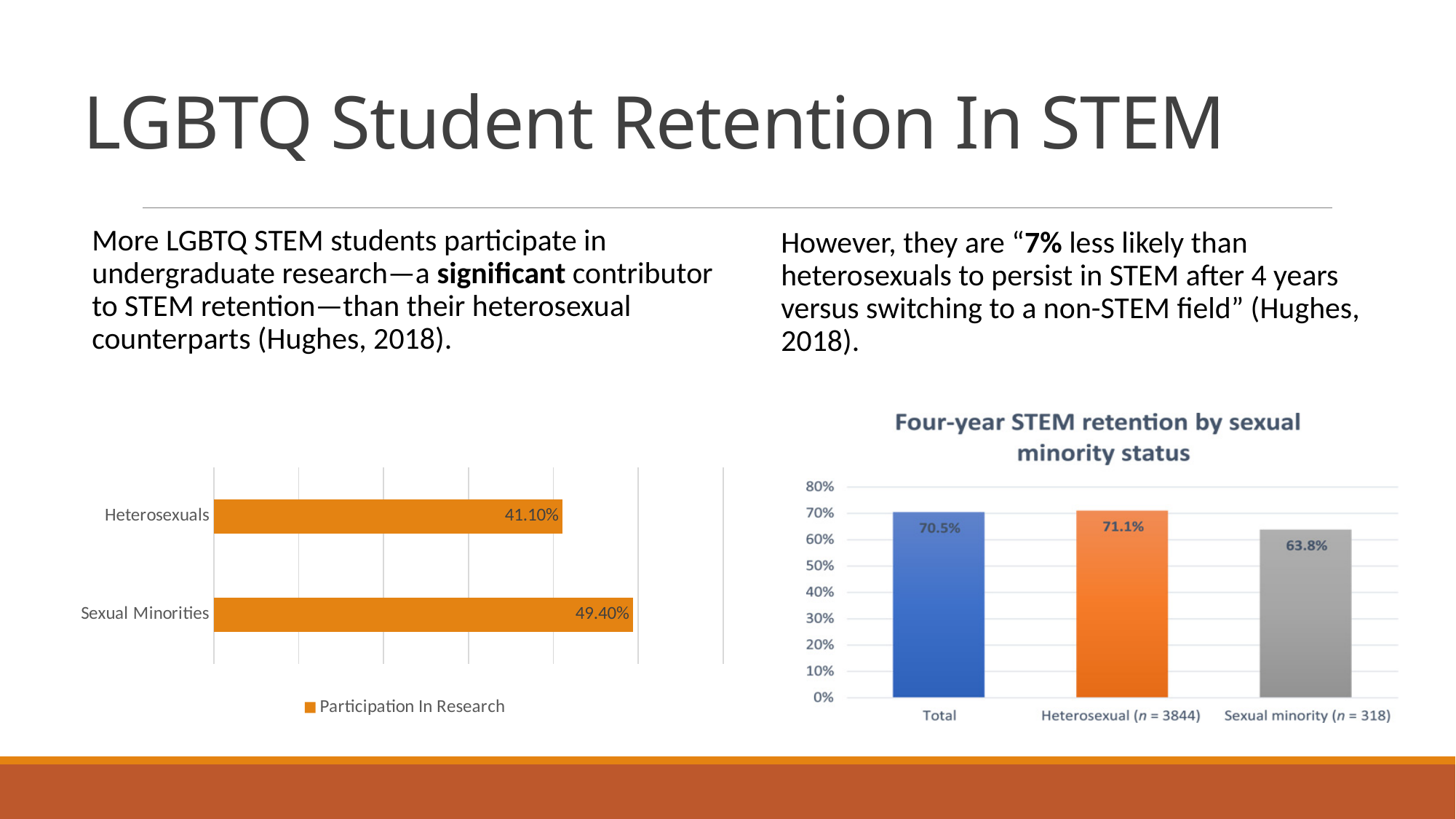
In the left chart, what series name does the legend show? Participation In Research In the left chart (Participation In Research), what is the value for Sexual Minorities? 49.40% What kind of chart is the left chart (Participation In Research)? Bar chart In the chart titled 'Four-year STEM retention by sexual minority status', is the value for Sexual minority (n = 318) greater or less than 70%? less In the chart titled 'Four-year STEM retention by sexual minority status', how many categories are shown? 3 In the chart titled 'Four-year STEM retention by sexual minority status', what is the value for Sexual minority (n = 318)? 63.8% In the chart titled 'Four-year STEM retention by sexual minority status', what is the difference between the Heterosexual (n = 3844) and Sexual minority (n = 318) values? 7.3% In the left chart (Participation In Research), what is the difference between the Sexual Minorities and Heterosexuals values? 8.30% In the chart titled 'Four-year STEM retention by sexual minority status', which category has the lowest value? Sexual minority (n = 318) In the left chart (Participation In Research), which category has the higher value? Sexual Minorities In the chart titled 'Four-year STEM retention by sexual minority status', what is the value for Total? 70.5% In the left chart (Participation In Research), what is the value for Heterosexuals? 41.10%